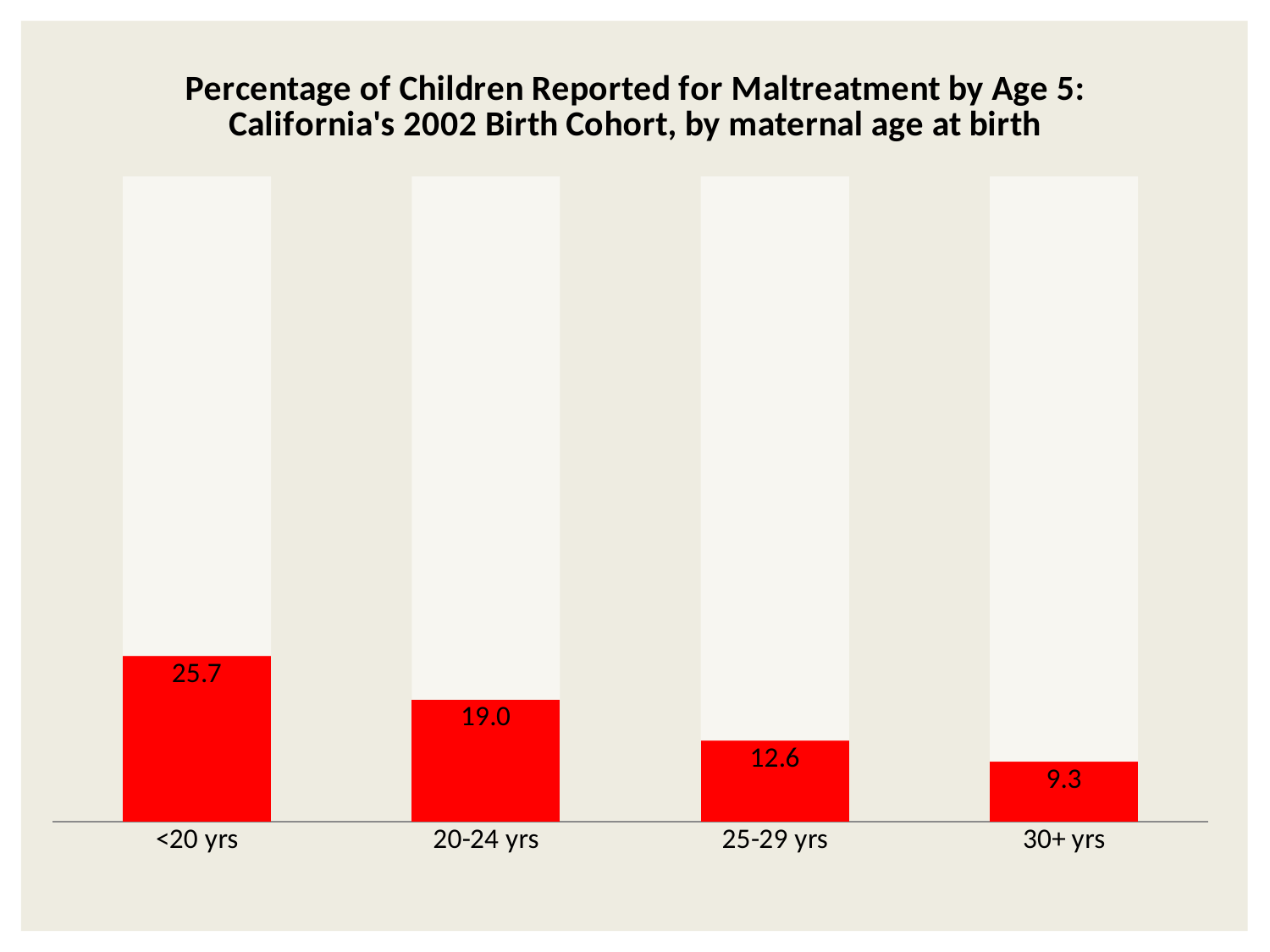
Which maternal age category has the lowest percentage? 30+ yrs What is the difference between the values for 20-24 yrs and 25-29 yrs? 6.4 What is the value for the 25-29 yrs category? 12.6 What is the difference between the values for <20 yrs and 30+ yrs? 16.4 What is the value for the <20 yrs category? 25.7 Which is larger, the value for 20-24 yrs or the value for 25-29 yrs? 20-24 yrs What kind of chart is shown on the slide? bar chart What is the value for the 30+ yrs category? 9.3 How many maternal age categories are shown on the chart? 4 Which maternal age category has the highest percentage? <20 yrs What is the value for the 20-24 yrs category? 19.0 Do the values rise or fall as maternal age increases along the x axis? fall